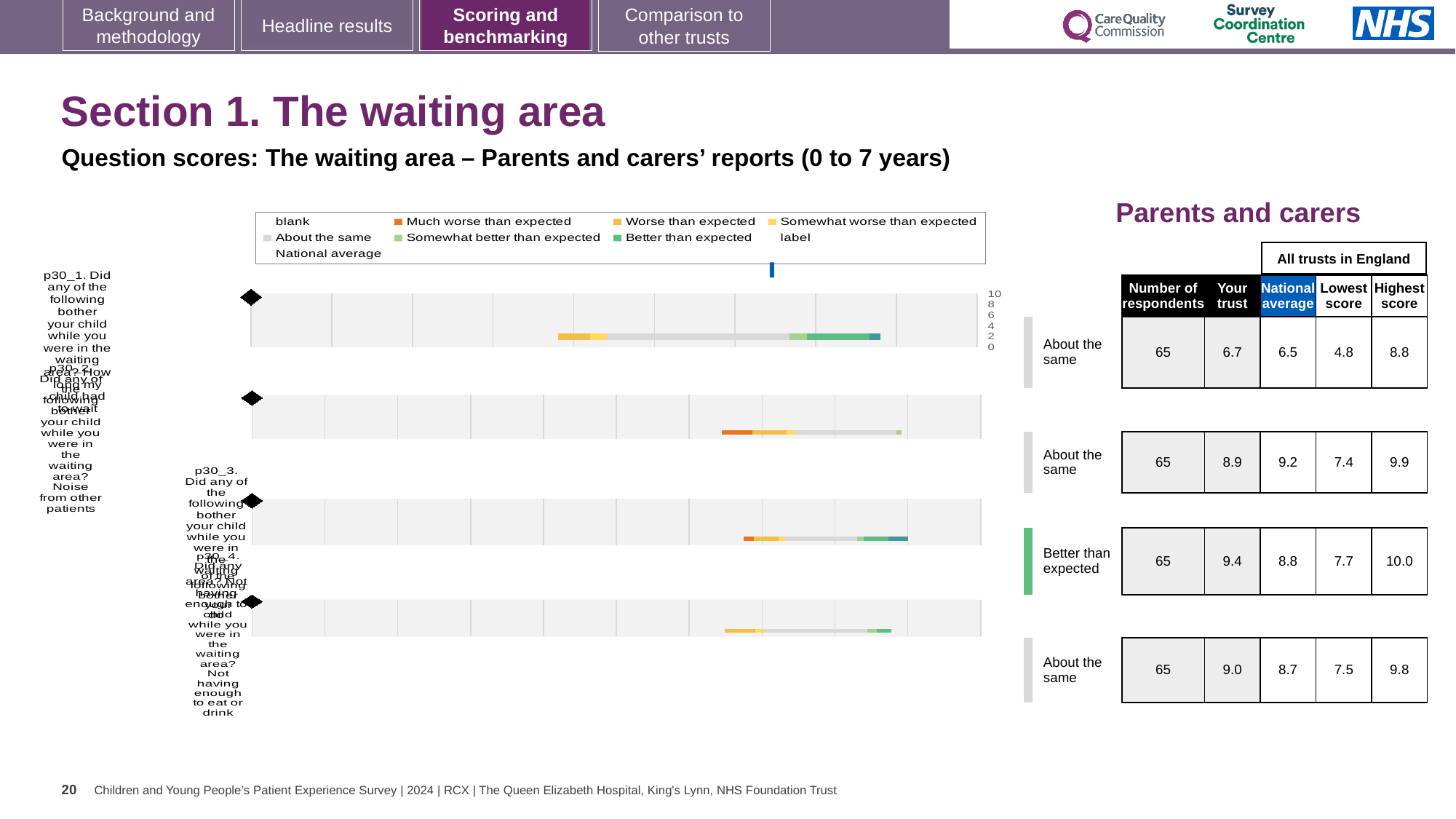
In the table, what is the 'Your trust' score in the row rated 'Better than expected'? 9.4 What kind of chart is shown on the slide? bar chart How many respondents are listed for each question in the table? 65 In the chart legend, what colour is used for 'Much worse than expected'? orange Which legend entry in the chart is represented by the dark blue marker? National average In the first row of the table, which is larger: the 'Your trust' score (6.7) or the National average (6.5)? Your trust What is the smallest 'Lowest score' value shown in the table? 4.8 How many question bars (p30_1 to p30_4) are plotted in the chart? 4 In the table, what is the National average in the row rated 'Better than expected'? 8.8 How many of the four questions are rated 'About the same'? 3 In the 'Better than expected' row, how much higher is the 'Your trust' score than the National average? 0.6 What is the largest 'Highest score' value shown in the table? 10.0